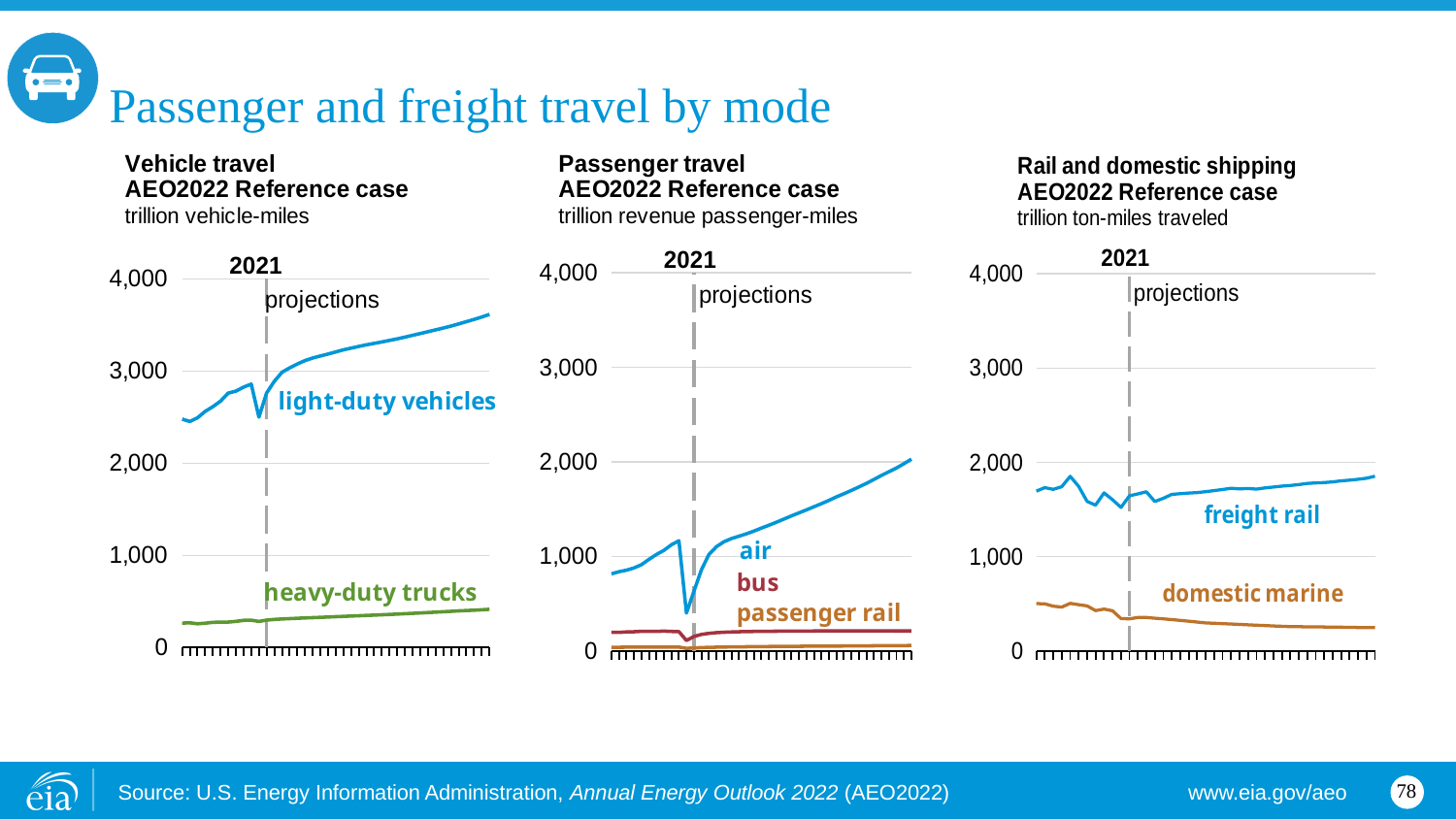
In the 'Passenger travel' chart, which series is the lowest? passenger rail In the 'Rail and domestic shipping' chart, is the value for domestic marine at the end of the projection period greater or less than 1,000? less In the 'Vehicle travel' chart, is the value for heavy-duty trucks at the end of the projection period greater or less than 1,000? less In the 'Passenger travel' chart, does the air series rise or fall over the projection period after 2021? rise In the 'Vehicle travel' chart, how many series are plotted? 2 In the 'Passenger travel' chart, is the value for air at the end of the projection period greater or less than 1,000? greater In the 'Rail and domestic shipping' chart, does the domestic marine series rise or fall over the projection period after 2021? fall What kind of chart is the 'Vehicle travel' chart? line chart In the 'Rail and domestic shipping' chart, which series is higher, freight rail or domestic marine? freight rail In the 'Passenger travel' chart, how many series are plotted? 3 What unit is shown for the 'Rail and domestic shipping' chart? trillion ton-miles traveled